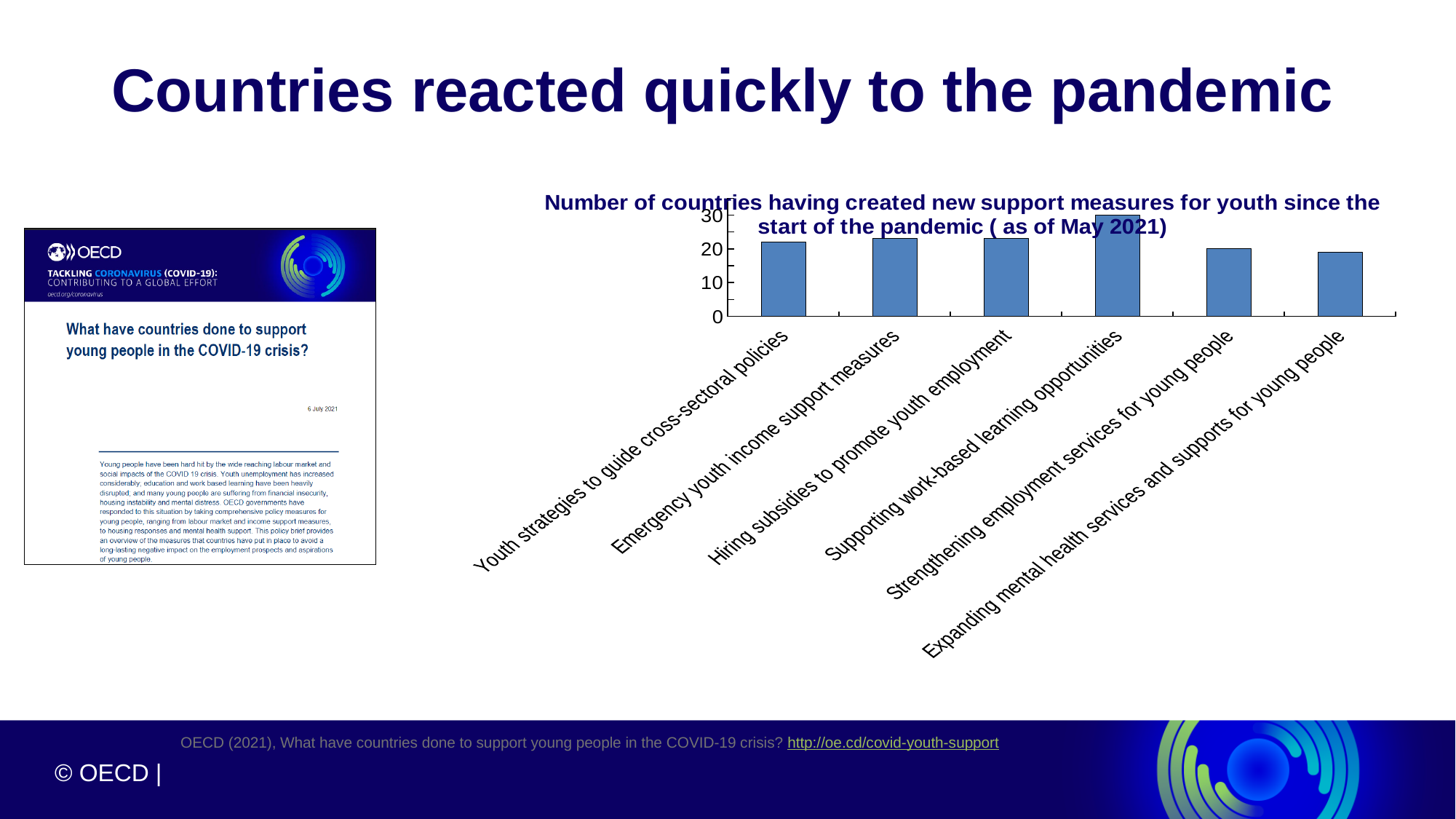
Which category has the highest number of countries? Supporting work-based learning opportunities Is the value for Expanding mental health services and supports for young people greater or less than 10? greater What is the highest value shown on the vertical axis of the chart? 30 What kind of chart is shown on the slide? bar chart How many categories are shown on the chart? 6 Is the value for Supporting work-based learning opportunities greater or less than 20? greater Which is larger: the value for Supporting work-based learning opportunities or the value for Youth strategies to guide cross-sectoral policies? Supporting work-based learning opportunities Is the value for Youth strategies to guide cross-sectoral policies greater or less than 10? greater Which is larger: the value for Expanding mental health services and supports for young people or the value for Supporting work-based learning opportunities? Supporting work-based learning opportunities What is the title of the chart? Number of countries having created new support measures for youth since the start of the pandemic ( as of May 2021)